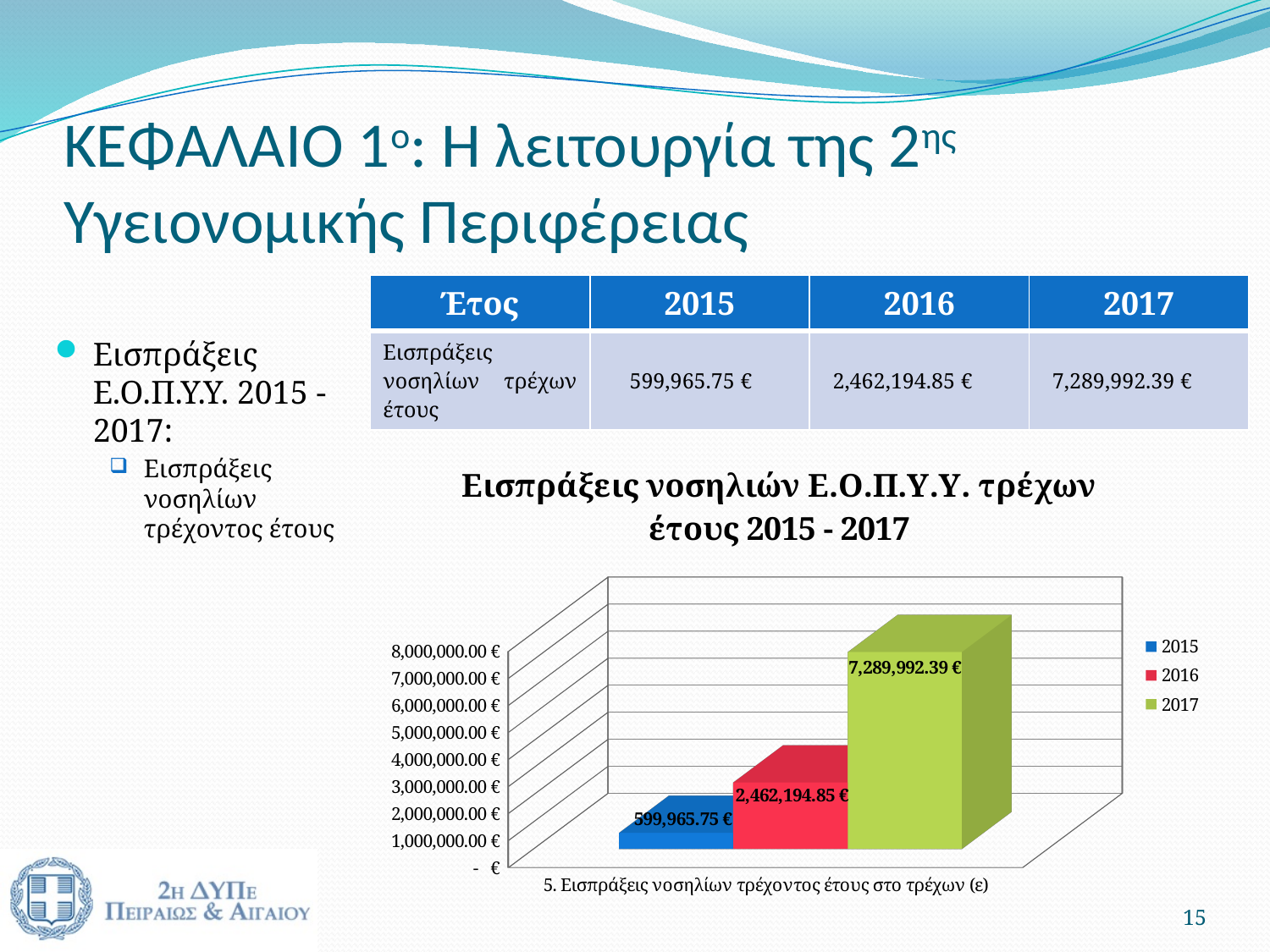
Which is larger in the chart, the value for 2016 or the value for 2015? 2016 Is the value for 2017 in the chart greater or less than 7,000,000.00 €? greater What is the value shown for 2017 in the chart? 7,289,992.39 € How many series does the chart legend list? 3 What is the difference between the 2016 and 2015 values in the chart? 1,862,229.10 € Which year has the lowest value in the chart? 2015 What colour is the bar for 2017 in the chart? green What type of chart is shown on the slide? bar chart What is the difference between the 2017 and 2016 values in the chart? 4,827,797.54 € What is the value shown for 2015 in the chart? 599,965.75 € Which year has the highest value in the chart? 2017 What is the value shown for 2016 in the chart? 2,462,194.85 €